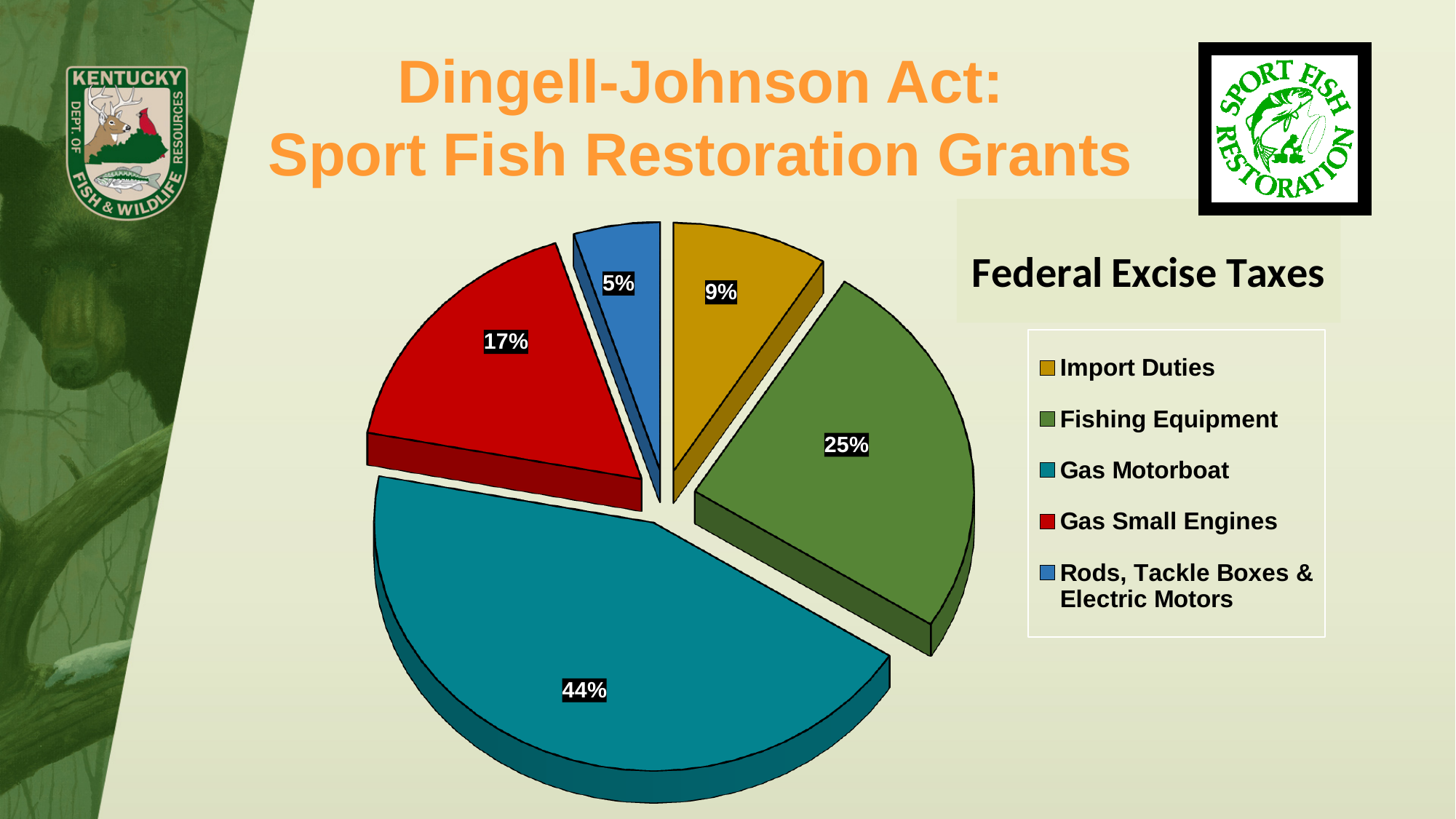
What is the heading shown next to the pie chart? Federal Excise Taxes What share of the pie does Fishing Equipment account for? 25% Which category has the largest slice of the pie? Gas Motorboat What kind of chart is shown on the slide? pie chart What share of the pie does Import Duties account for? 9% What share of the pie does Rods, Tackle Boxes & Electric Motors account for? 5% How many categories does the pie chart have? 5 Which category has the smallest slice of the pie? Rods, Tackle Boxes & Electric Motors Which is larger, the share for Gas Small Engines or the share for Import Duties? Gas Small Engines What is the difference in percentage points between Gas Motorboat and Fishing Equipment? 19